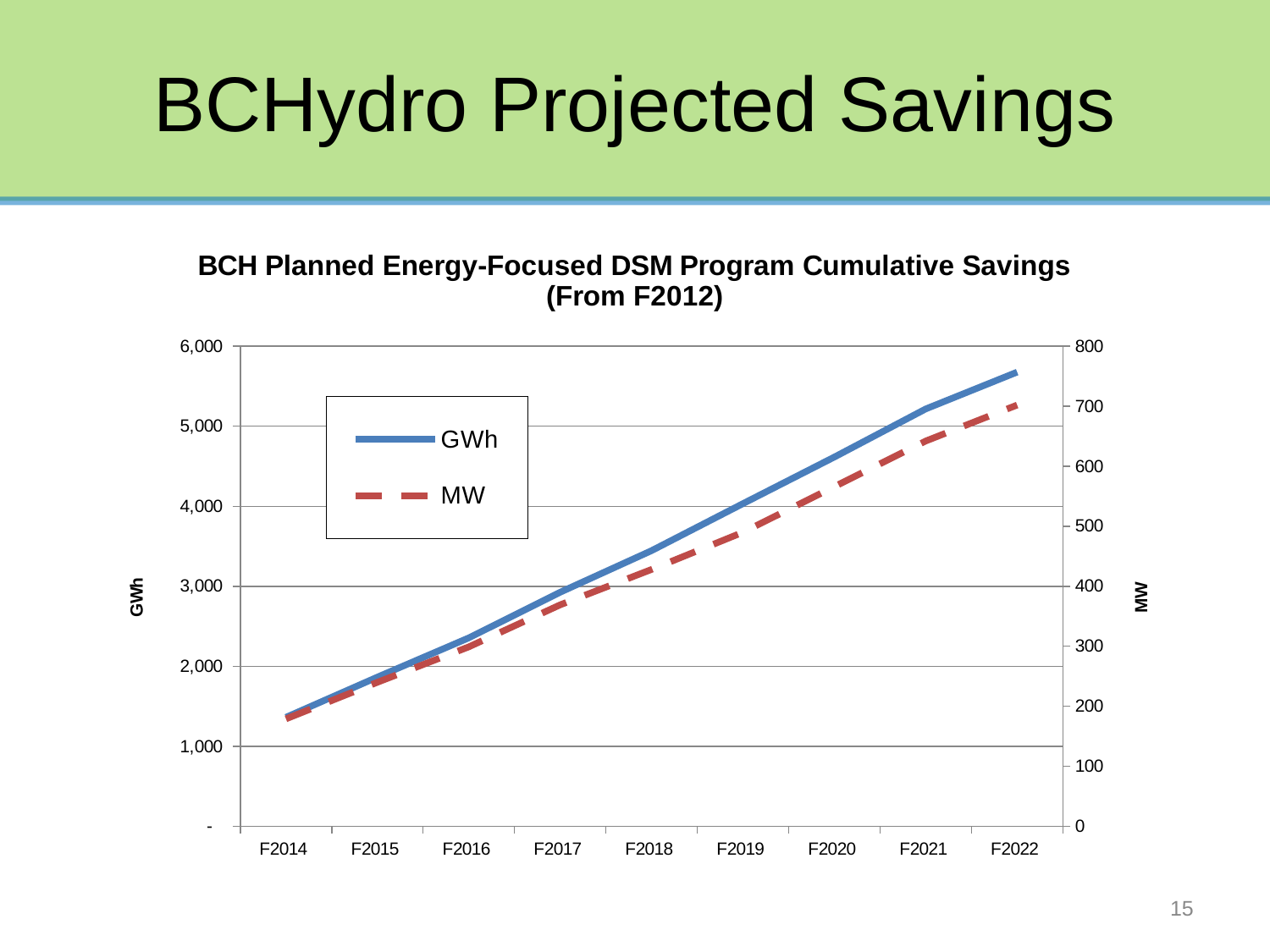
Which series is drawn with a dashed red line? MW What kind of chart is shown on the slide? line chart Is the MW value for F2022 greater or less than 600? greater Is the MW value for F2016 greater or less than 400? less Is the GWh value for F2014 greater or less than 2,000? less Do the GWh values rise or fall from F2014 to F2022? rise How many series does the legend list? 2 In which year is the MW series at its lowest? F2014 How many fiscal years are plotted along the x axis? 9 In which year is the GWh series at its highest? F2022